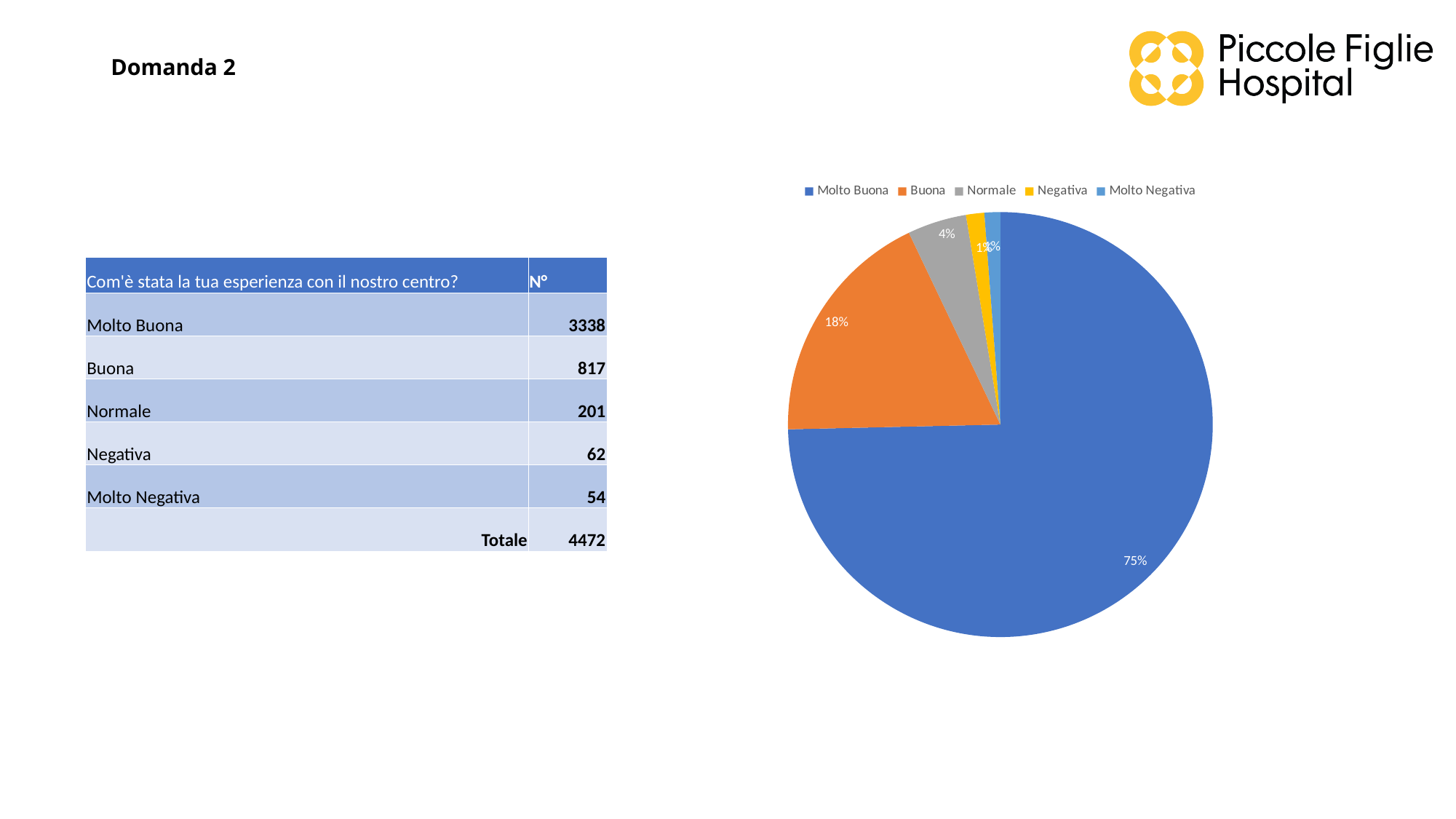
What share of the pie does the Normale slice represent? 4% What share of the pie does the Molto Buona slice represent? 75% What is the difference in percentage points between the Molto Buona slice and the Buona slice? 57% Which category is shown in yellow in the pie chart legend? Negativa Which category has the largest slice of the pie? Molto Buona How many slices does the pie chart have? 5 What kind of chart is shown on the slide? pie chart Which slice is larger, Buona or Normale? Buona Which slice is larger, Molto Buona or Buona? Molto Buona How many entries does the legend of the pie chart list? 5 What colour is the Molto Buona slice in the pie chart? blue What share of the pie does the Buona slice represent? 18%